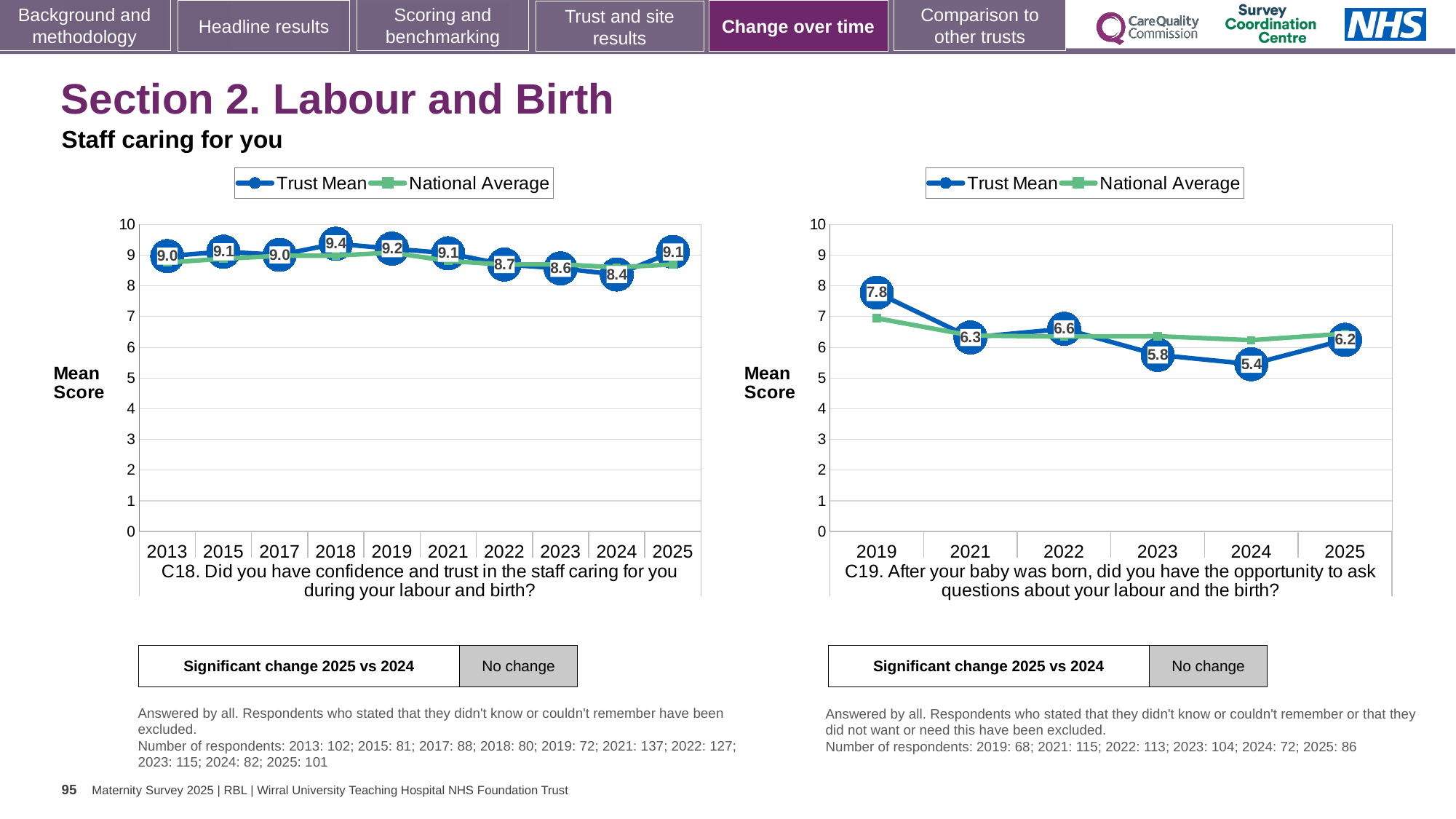
How many series does the legend of the C19 chart (right) list? 2 In the C18 chart (left), which year has the lowest Trust Mean? 2024 In the C18 chart (left), which year has the highest Trust Mean? 2018 How many years are plotted on the x axis of the C18 chart (left)? 10 In the C19 chart (right), is the Trust Mean for 2022 larger or smaller than the Trust Mean for 2023? larger In the C18 chart (left), what is the Trust Mean for 2024? 8.4 In the C18 chart (left), what is the difference between the Trust Mean for 2025 and 2024? 0.7 In the C19 chart (right), what is the Trust Mean for 2019? 7.8 In the C19 chart (right), what is the difference between the Trust Mean for 2019 and 2025? 1.6 In the C18 chart (left), what is the Trust Mean for 2018? 9.4 In the C19 chart (right), is the National Average for 2019 greater or less than 6? greater In the C19 chart (right), which year has the lowest Trust Mean? 2024